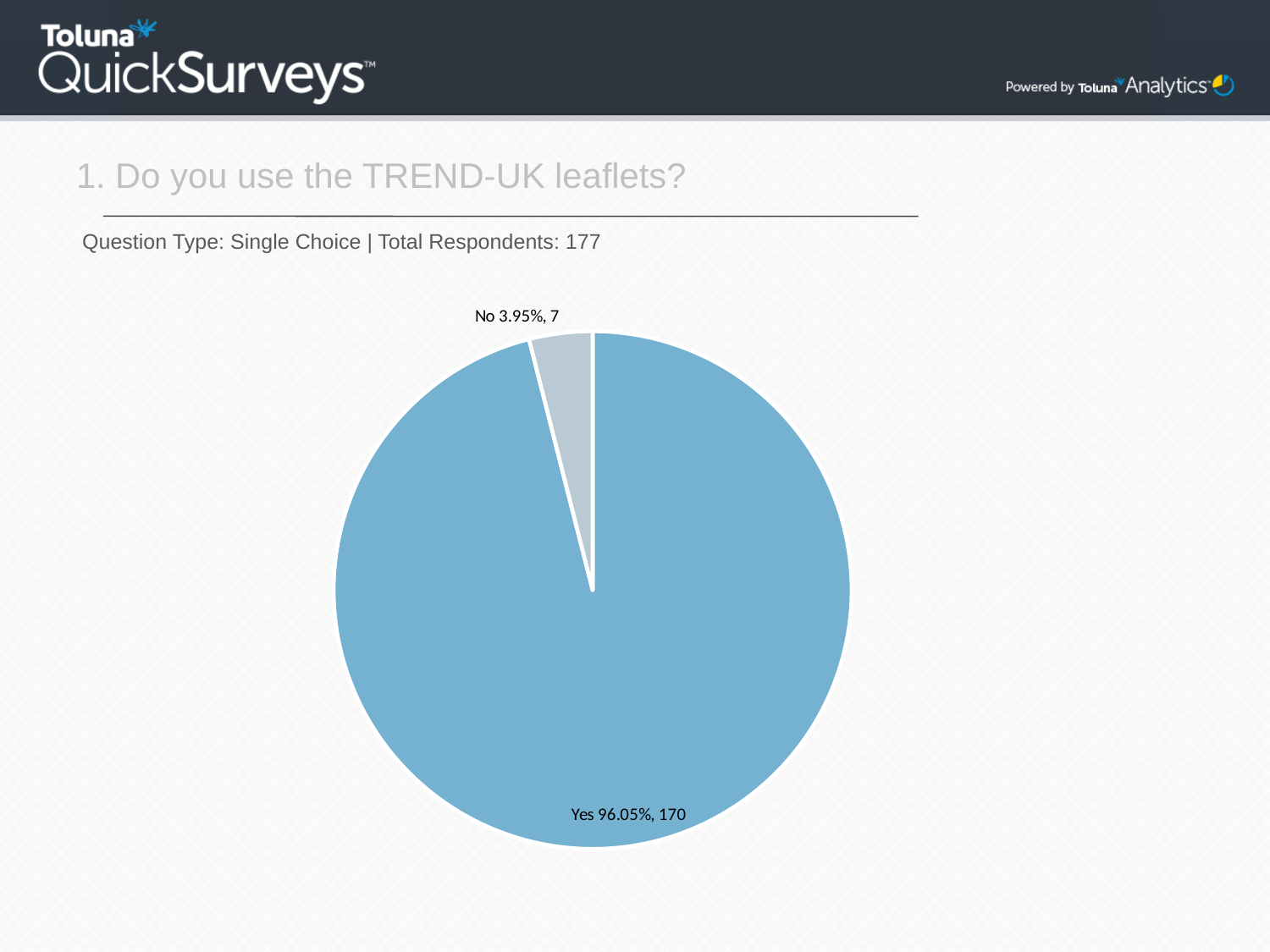
Which response has the largest share of the pie? Yes What is the total number of respondents shown on the slide? 177 Which response had more respondents, "Yes" or "No"? Yes How many respondents answered "No"? 7 What kind of chart is shown on the slide? pie chart How many slices does the pie chart have? 2 What percentage of respondents answered "No"? 3.95% How many respondents answered "Yes"? 170 What is the question title shown above the chart? 1. Do you use the TREND-UK leaflets? Which response has the smallest share of the pie? No What is the difference in respondent counts between "Yes" and "No"? 163 What percentage of respondents answered "Yes"? 96.05%